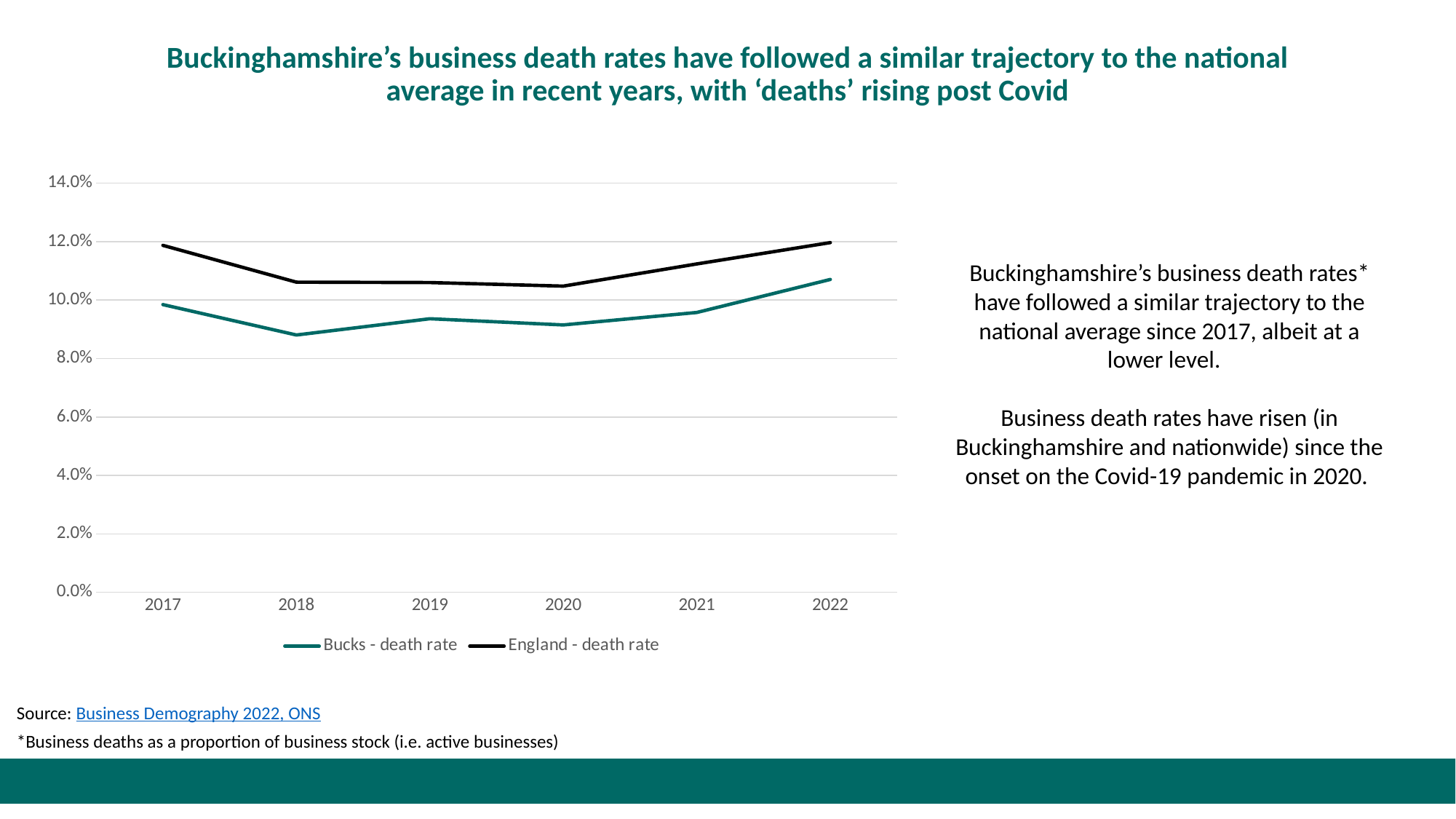
In which year is the Bucks death rate at its lowest? 2018 Is the England death rate in 2017 greater or less than 10.0%? greater What are the two series named in the chart's legend? Bucks - death rate and England - death rate In which year is the Bucks death rate at its highest? 2022 Which series has the higher death rate in 2017, Bucks or England? England - death rate How many series does the chart's legend list? 2 How many years are plotted along the x axis of the chart? 6 Is the Bucks death rate in 2018 greater or less than 10.0%? less Does the Bucks death rate rise or fall between 2020 and 2022? rise Does the England death rate rise or fall between 2017 and 2018? fall What kind of chart is shown on the slide? Line chart Is the Bucks death rate in 2022 greater or less than 10.0%? greater